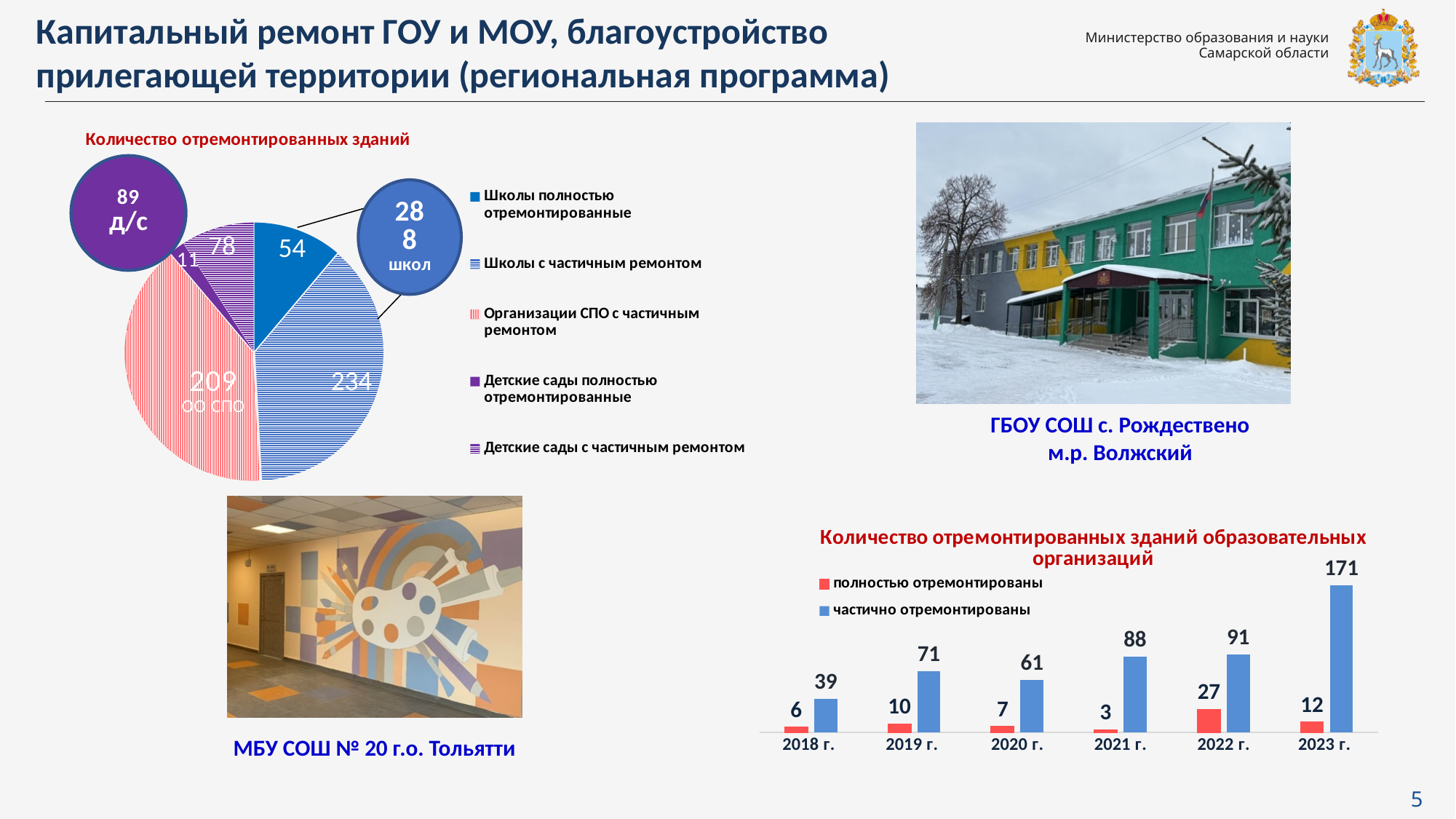
In the bar chart "Количество отремонтированных зданий образовательных организаций", which year has the lowest value for "полностью отремонтированы"? 2021 г. In the bar chart "Количество отремонтированных зданий образовательных организаций", what is the value for "частично отремонтированы" in 2023 г.? 171 In the pie chart "Количество отремонтированных зданий", which category has the smallest slice? Детские сады полностью отремонтированные In the bar chart "Количество отремонтированных зданий образовательных организаций", what is the value for "полностью отремонтированы" in 2022 г.? 27 What kind of chart is "Количество отремонтированных зданий" on the left of the slide? Pie chart In the bar chart "Количество отремонтированных зданий образовательных организаций", which year has the larger value for "частично отремонтированы": 2019 г. or 2020 г.? 2019 г. In the bar chart "Количество отремонтированных зданий образовательных организаций", by how much does "частично отремонтированы" in 2023 г. exceed that in 2022 г.? 80 How many series does the legend of the bar chart "Количество отремонтированных зданий образовательных организаций" list? 2 In the pie chart "Количество отремонтированных зданий", how many categories are shown? 5 In the pie chart "Количество отремонтированных зданий", what is the value for "Школы с частичным ремонтом"? 234 In the pie chart "Количество отремонтированных зданий", what is the difference between "Школы с частичным ремонтом" and "Организации СПО с частичным ремонтом"? 25